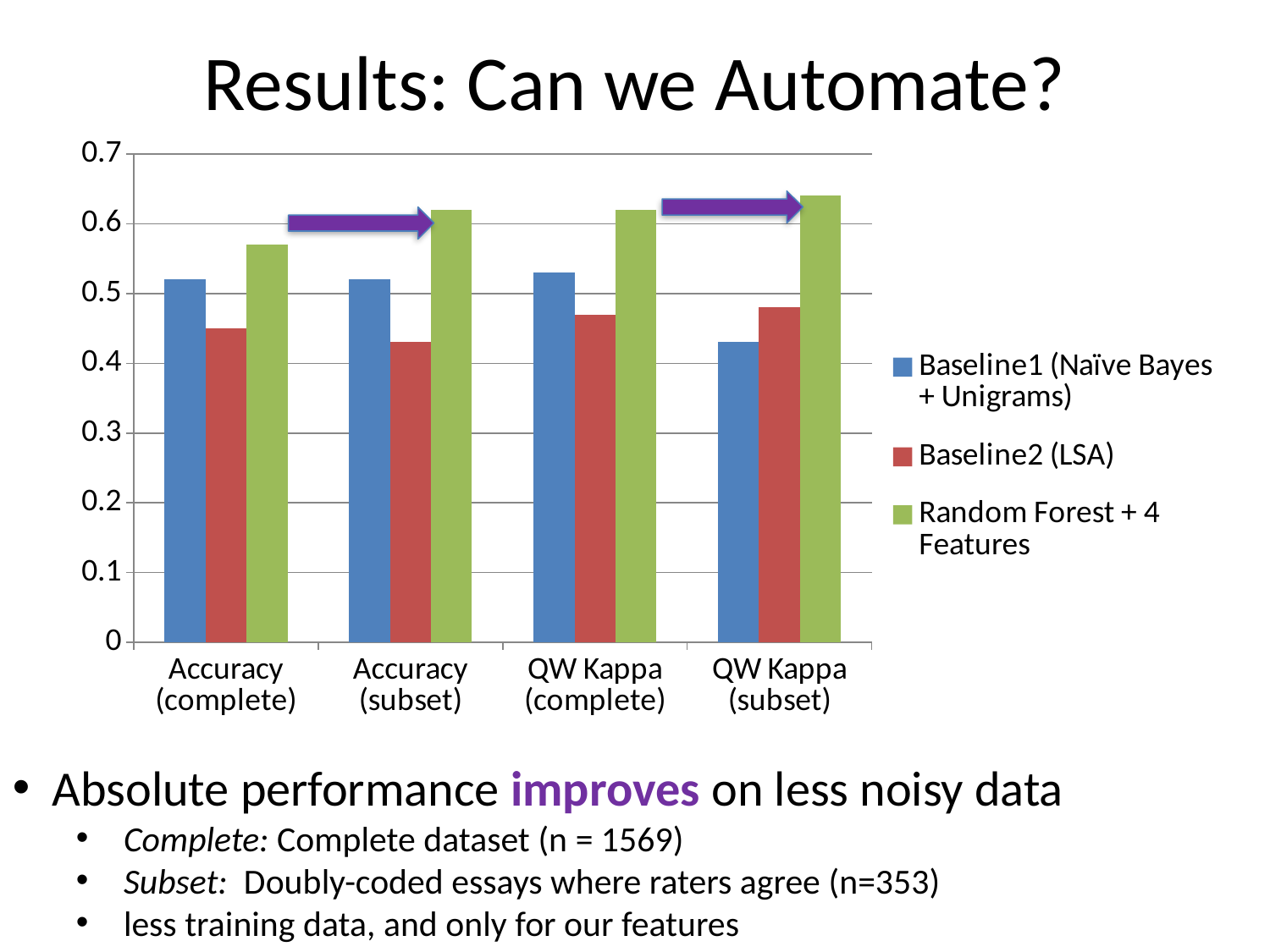
For QW Kappa (subset), which is larger: Baseline1 (Naïve Bayes + Unigrams) or Baseline2 (LSA)? Baseline2 (LSA) What colour are the bars for the Random Forest + 4 Features series? green What kind of chart is shown on the slide? bar chart Which series has the lowest bar for Accuracy (subset)? Baseline2 (LSA) For Accuracy (complete), which is larger: Baseline1 (Naïve Bayes + Unigrams) or Baseline2 (LSA)? Baseline1 (Naïve Bayes + Unigrams) Is the value for Baseline2 (LSA) in Accuracy (subset) greater or less than 0.5? less Is the value for Random Forest + 4 Features in QW Kappa (subset) greater or less than 0.6? greater How many series does the chart's legend list? 3 How many categories are shown on the x axis of the chart? 4 Is the value for Random Forest + 4 Features in Accuracy (complete) greater or less than 0.6? less Which series has the highest bar for QW Kappa (subset)? Random Forest + 4 Features